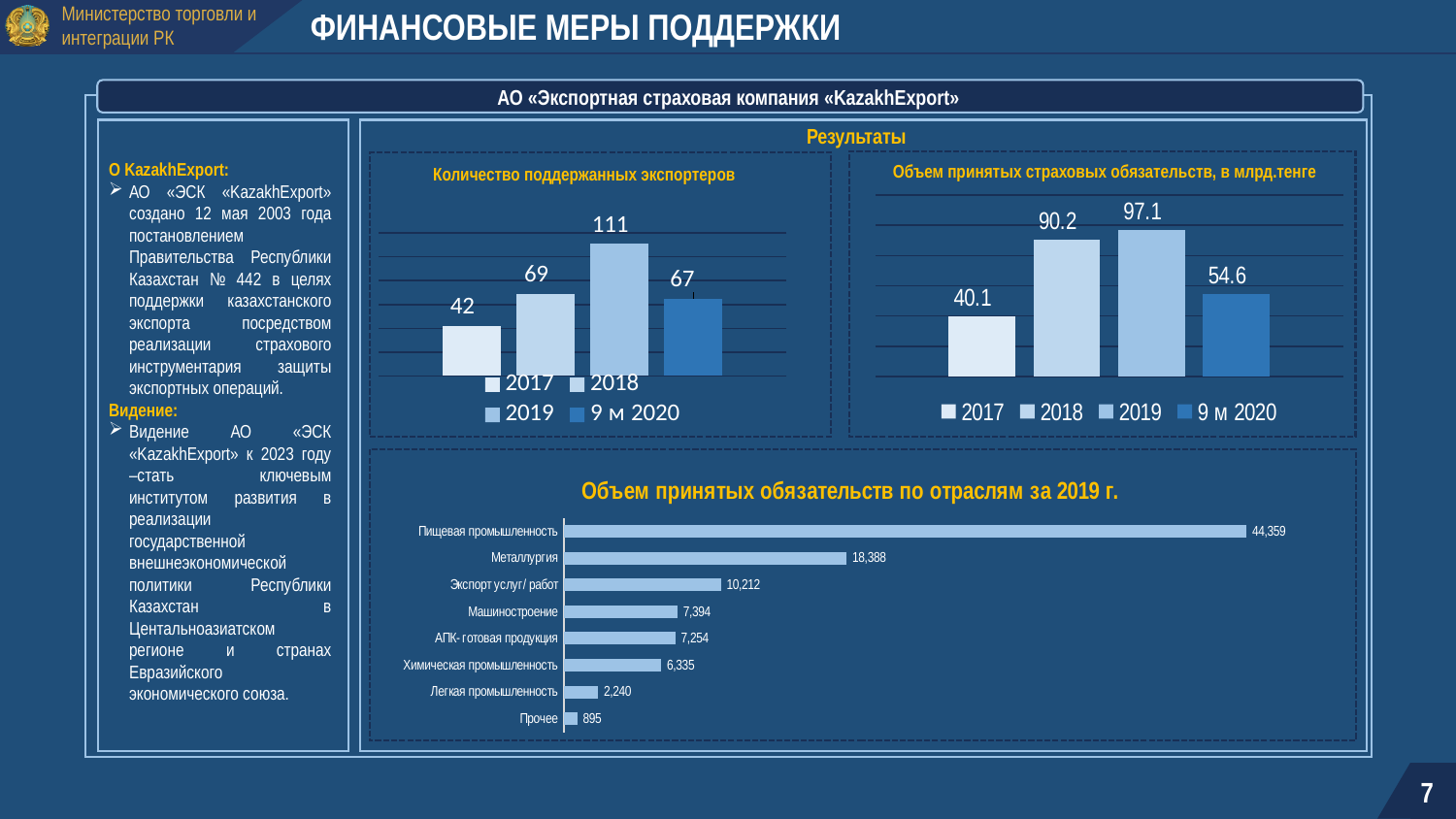
What type of chart is "Объем принятых обязательств по отраслям за 2019 г."? Bar chart In the chart "Количество поддержанных экспортеров", how many series does the legend list? 4 In the chart "Объем принятых страховых обязательств, в млрд.тенге", which is larger: the value for 2017 or for 9 м 2020? 9 м 2020 In the chart "Объем принятых страховых обязательств, в млрд.тенге", what is the difference between the 2019 and 2017 values? 57.0 In the chart "Объем принятых страховых обязательств, в млрд.тенге", which period has the highest value? 2019 In the chart "Количество поддержанных экспортеров", what is the difference between the 2019 and 2018 values? 42 In the chart "Объем принятых обязательств по отраслям за 2019 г.", what is the value for Металлургия? 18,388 In the chart "Количество поддержанных экспортеров", what is the value for 2019? 111 In the chart "Количество поддержанных экспортеров", which year has the lowest value? 2017 In the chart "Объем принятых обязательств по отраслям за 2019 г.", how many categories are shown? 8 In the chart "Объем принятых обязательств по отраслям за 2019 г.", which category has the highest value? Пищевая промышленность In the chart "Объем принятых страховых обязательств, в млрд.тенге", what is the value for 2018? 90.2